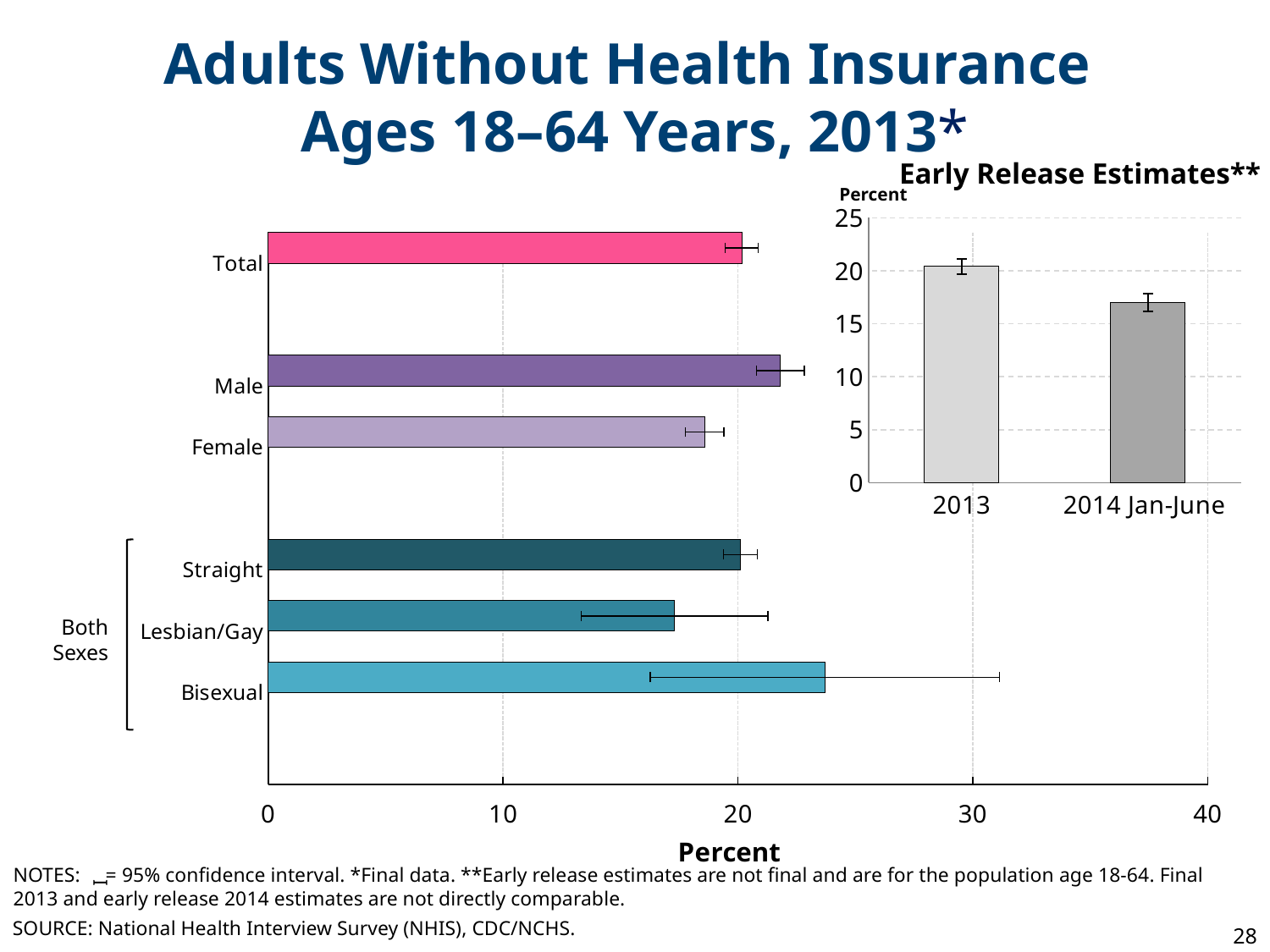
In the main chart 'Adults Without Health Insurance Ages 18–64 Years, 2013', is the value for Female greater or less than 20? less How many bars are plotted in the main chart 'Adults Without Health Insurance Ages 18–64 Years, 2013'? 6 In the 'Early Release Estimates' chart, which is larger, the value for 2013 or the value for 2014 Jan-June? 2013 In the main chart 'Adults Without Health Insurance Ages 18–64 Years, 2013', is the value for Lesbian/Gay greater or less than 20? less In the main chart 'Adults Without Health Insurance Ages 18–64 Years, 2013', which category has the highest percentage? Bisexual In the main chart 'Adults Without Health Insurance Ages 18–64 Years, 2013', is the value for Male greater or less than 20? greater In the main chart 'Adults Without Health Insurance Ages 18–64 Years, 2013', which category has the lowest percentage? Lesbian/Gay In the main chart 'Adults Without Health Insurance Ages 18–64 Years, 2013', which is larger, the value for Male or the value for Female? Male What is the label on the horizontal axis of the main chart 'Adults Without Health Insurance Ages 18–64 Years, 2013'? Percent What kind of chart is the main chart 'Adults Without Health Insurance Ages 18–64 Years, 2013'? Bar chart